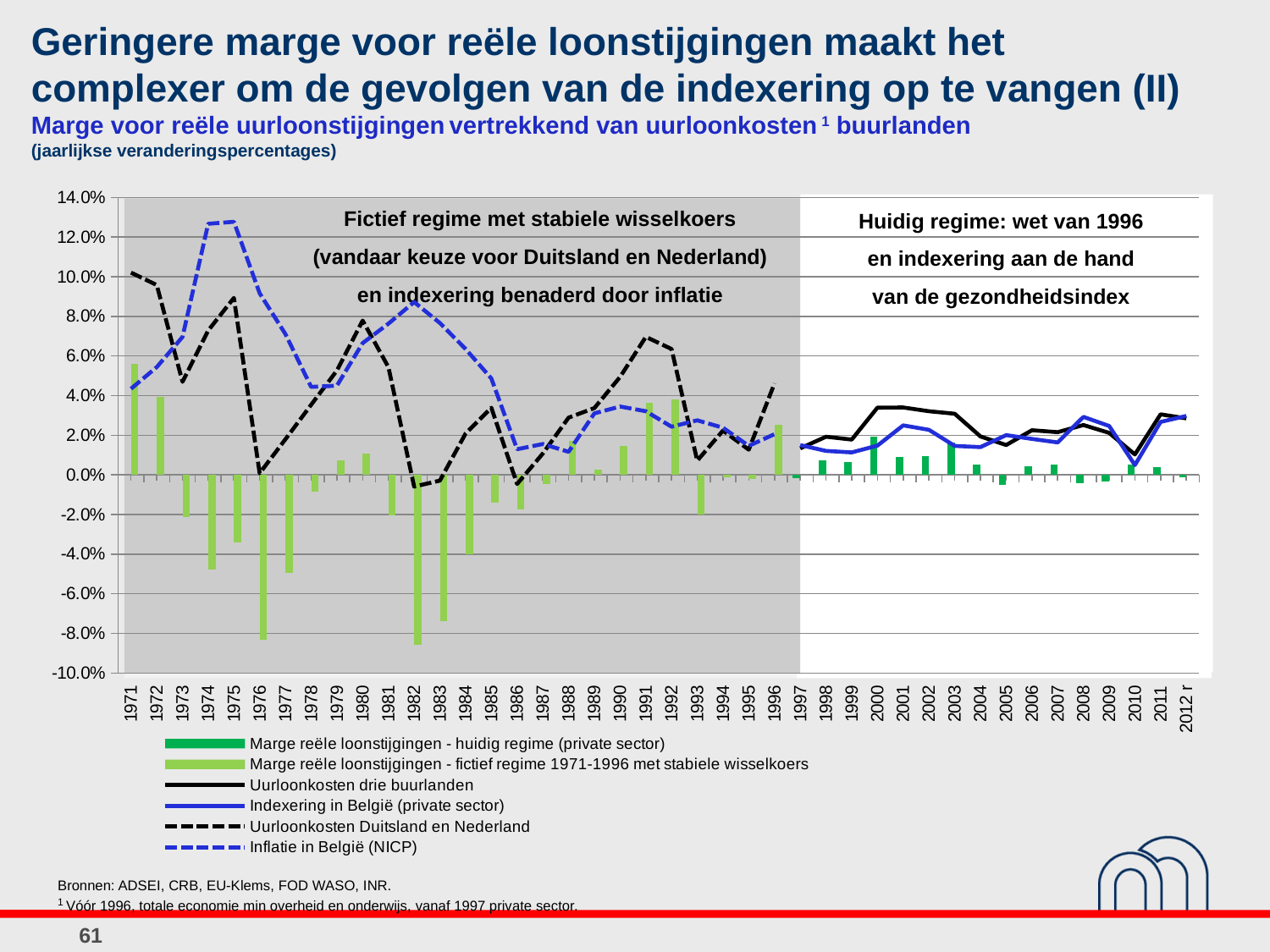
Which is larger: the bar for 1971 or the bar for 1972 (fictief regime)? 1971 What is the first line of the text shown in the white area of the chart (1997 onwards)? Huidig regime: wet van 1996 Which series is drawn as a blue dashed line? Inflatie in België (NICP) Is the value of 'Uurloonkosten Duitsland en Nederland' in 1980 greater or less than 6.0%? greater Which year has the highest bar for 'Marge reële loonstijgingen - fictief regime 1971-1996 met stabiele wisselkoers'? 1971 What kind of chart is shown on the slide? Combined bar and line chart Is the bar for 1982 (fictief regime) greater or less than -6.0%? less How many series does the legend list? 6 Does the 'Inflatie in België (NICP)' line rise or fall between 1975 and 1986? fall Is the value of 'Inflatie in België (NICP)' in 1975 greater or less than 12.0%? greater How many years are shown on the x axis of the chart? 42